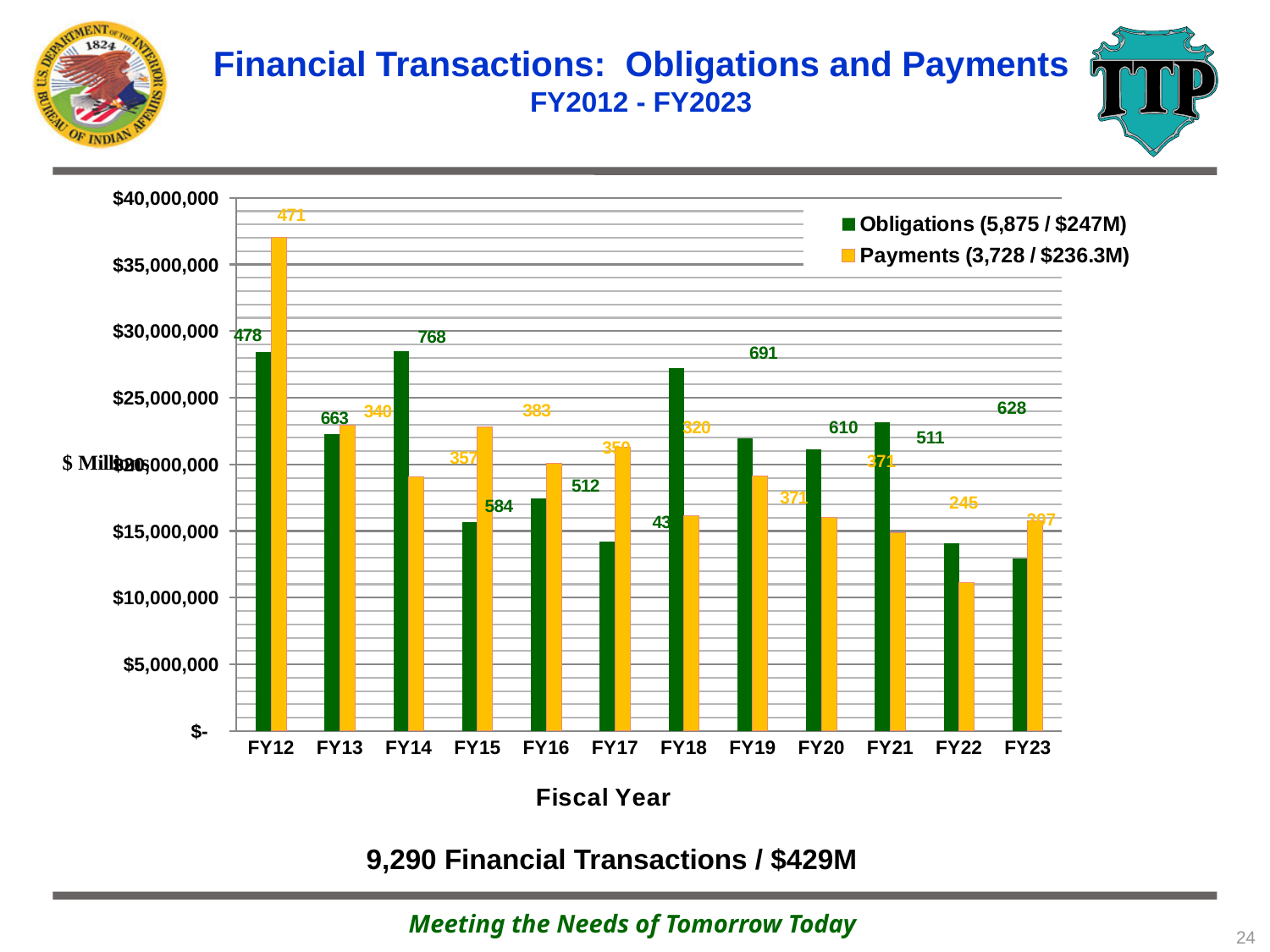
Is the Obligations value for FY18 greater or less than $25,000,000? greater Is the Payments value for FY20 greater or less than $20,000,000? less Which fiscal year has the highest Payments bar? FY12 What kind of chart is shown on the slide? bar chart Is the Payments value for FY12 greater or less than $35,000,000? greater How many fiscal years are shown on the x axis? 12 In FY17, which is larger, Obligations or Payments? Payments In FY14, which is larger, Obligations or Payments? Obligations Which fiscal year has the lowest Payments bar? FY22 How many series does the legend list? 2 What is the title of the x axis? Fiscal Year